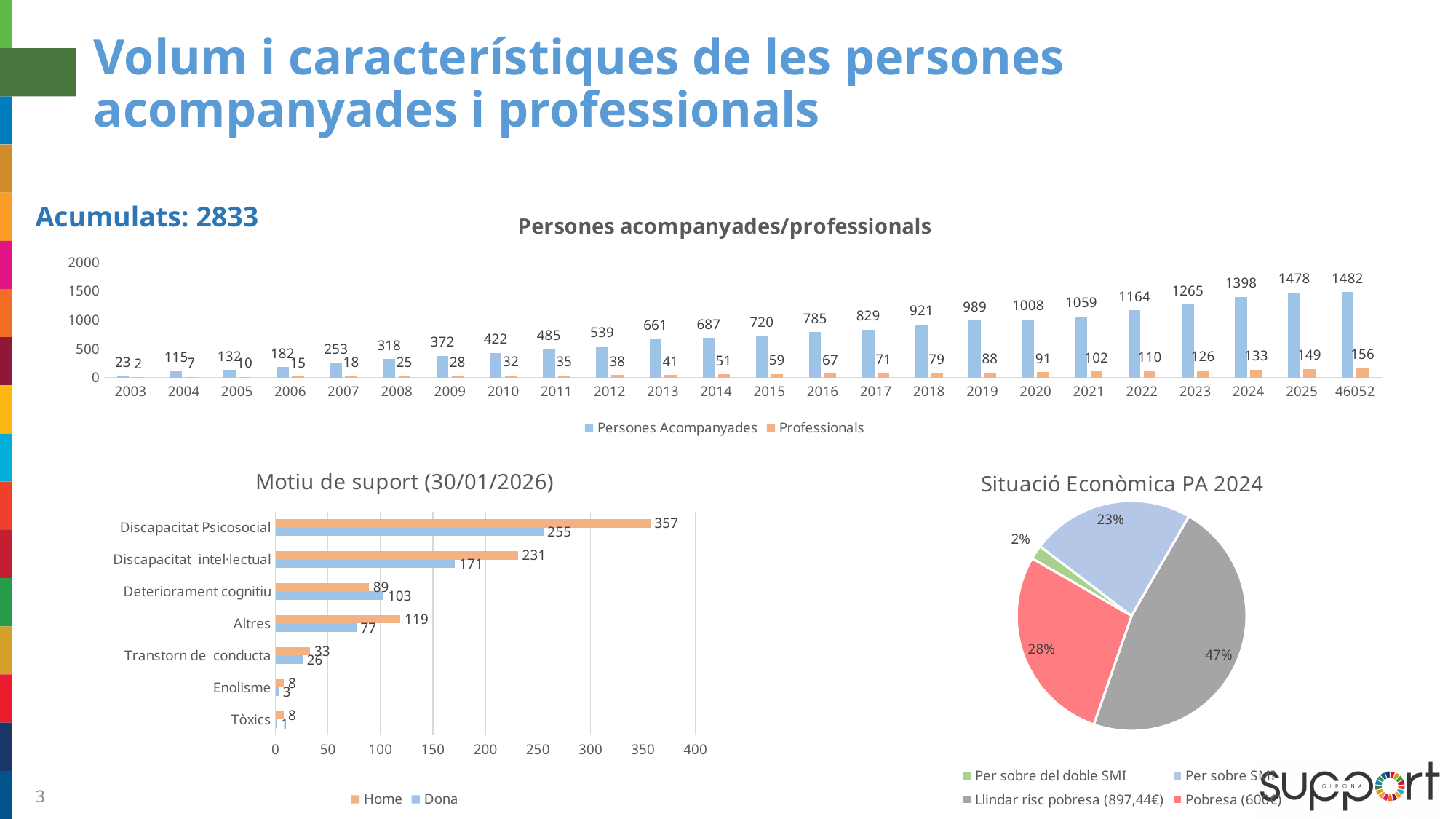
In the 'Persones acompanyades/professionals' chart, what is the difference between Persones Acompanyades and Professionals in 2025? 1329 In the 'Motiu de suport (30/01/2026)' chart, what is the Home value for Discapacitat Psicosocial? 357 What kind of chart is 'Motiu de suport (30/01/2026)'? bar chart In the 'Persones acompanyades/professionals' chart, what is the value for Professionals in 2020? 91 In the 'Motiu de suport (30/01/2026)' chart, how many categories are shown? 7 In the 'Motiu de suport (30/01/2026)' chart, which is larger for Deteriorament cognitiu, Home or Dona? Dona In the 'Situació Econòmica PA 2024' pie chart, what share does Llindar risc pobresa (897,44€) have? 47% In the 'Situació Econòmica PA 2024' pie chart, which category has the smallest slice? Per sobre del doble SMI In the 'Persones acompanyades/professionals' chart, do the Persones Acompanyades values rise or fall from 2003 to 2025? rise In the 'Motiu de suport (30/01/2026)' chart, which category has the lowest Dona value? Tòxics In the 'Persones acompanyades/professionals' chart, what is the value for Persones Acompanyades in 2015? 720 In the 'Persones acompanyades/professionals' chart, how many series does the legend list? 2